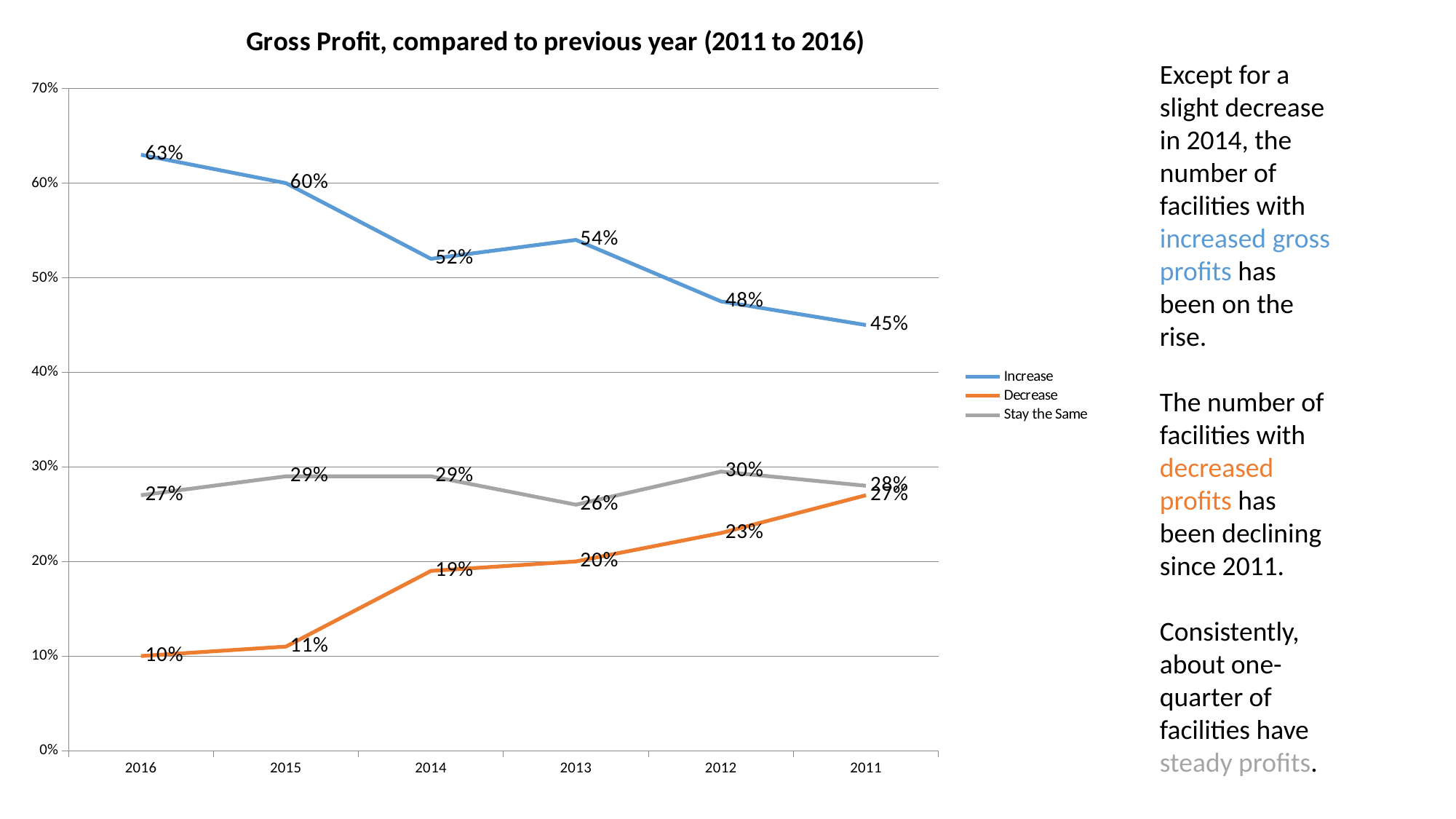
Which is larger, the Decrease value for 2012 or the Stay the Same value for 2012? Stay the Same In which year is the Increase series highest? 2016 What is the value of the Decrease series for 2014? 19% What is the difference between the Increase values for 2016 and 2011? 18% What is the value of the Stay the Same series for 2013? 26% Moving from left to right along the x axis (2016 to 2011), does the Decrease series rise or fall? rise What is the value of the Increase series for 2011? 45% In which year is the Decrease series lowest? 2016 How many series does the legend list? 3 How many years are shown on the x axis? 6 What is the value of the Increase series for 2016? 63% What type of chart is shown on the slide? line chart